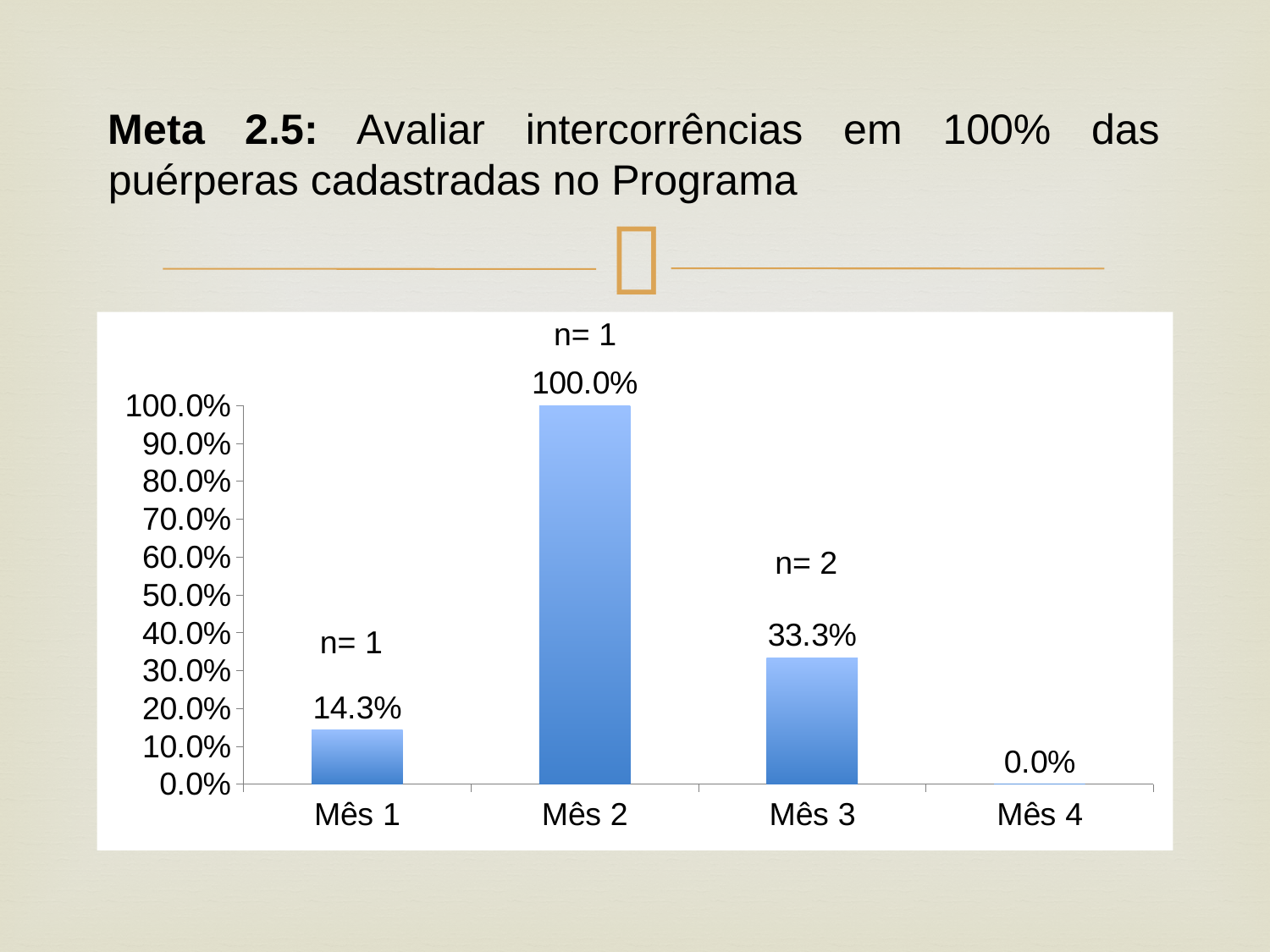
How many months are shown on the x axis? 4 What is the value for Mês 4? 0.0% Which month has the lowest value? Mês 4 What is the difference between the values for Mês 2 and Mês 3? 66.7% What is the value for Mês 1? 14.3% What is the value for Mês 3? 33.3% What is the difference between the values for Mês 3 and Mês 1? 19.0% Which month has the highest value? Mês 2 What is the value for Mês 2? 100.0% What kind of chart is shown on the slide? Bar chart Which is larger, the value for Mês 1 or the value for Mês 3? Mês 3 What is the n value shown above the bar for Mês 3? n= 2